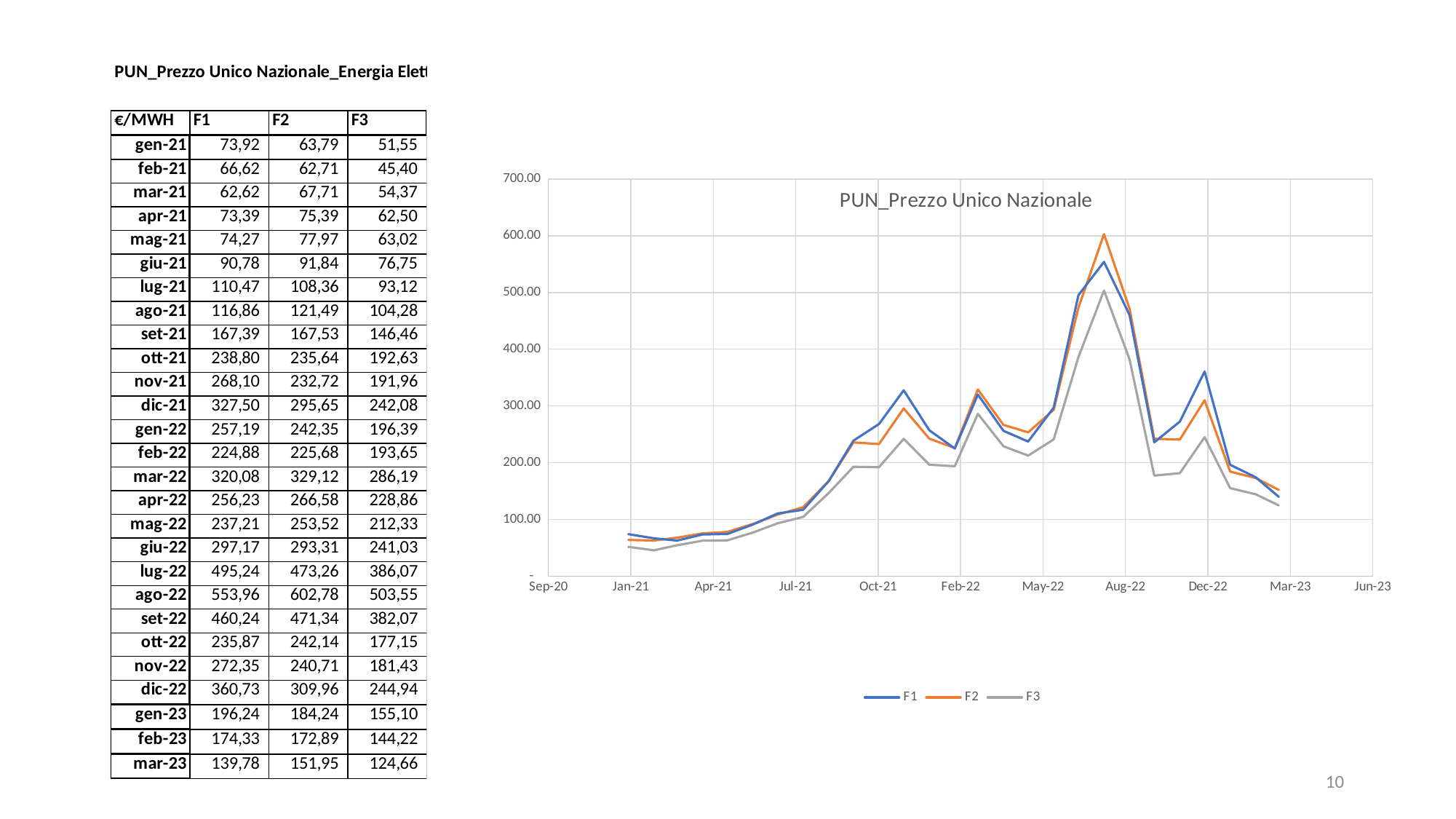
Do the values rise or fall between Aug-22 and Oct-22? fall Is the F1 value at Aug-22 greater or less than 500? greater What is the title of the chart? PUN_Prezzo Unico Nazionale Which series reaches the highest peak on the chart? F2 According to the table, what is the F2 value for ago-22? 602,78 Which series is the lowest at the Aug-22 peak? F3 According to the table, what is the F3 value for gen-21? 51,55 At Dec-22, which series has the larger value, F1 or F2? F1 How many series does the chart legend list? 3 What kind of chart is shown on the slide? line chart Is the F3 value at Aug-22 greater or less than 600? less Using the table values, what is the difference between F1 and F3 for ago-22? 50,41